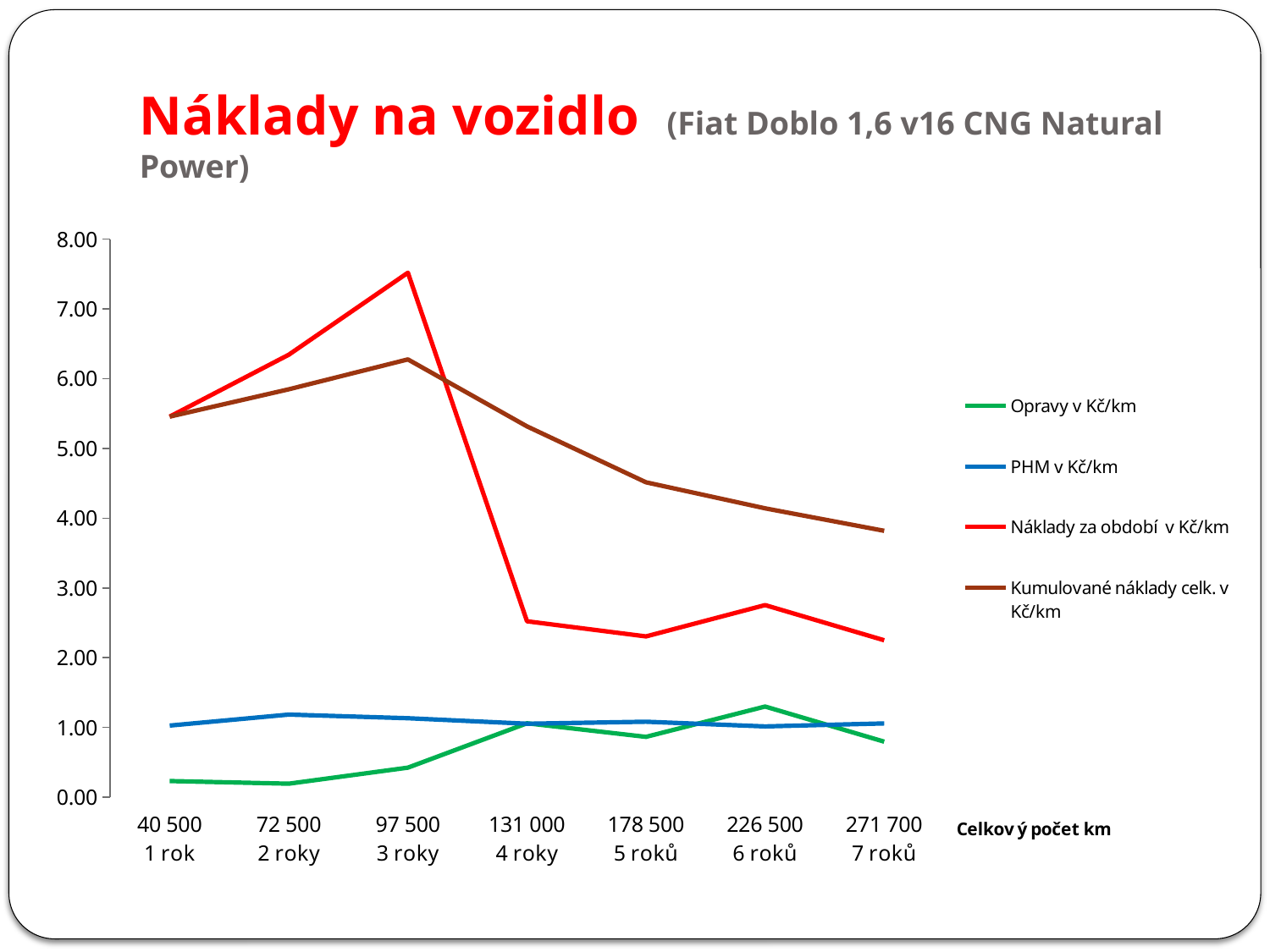
Is the value of 'Opravy v Kč/km' at 40 500 km (1 rok) greater or less than 1.00? less At 131 000 km (4 roky), which is higher: 'Náklady za období v Kč/km' or 'Kumulované náklady celk. v Kč/km'? Kumulované náklady celk. v Kč/km Is the value of 'Kumulované náklady celk. v Kč/km' at 97 500 km (3 roky) greater or less than 6.00? greater Is the value of 'Kumulované náklady celk. v Kč/km' at 271 700 km (7 roků) greater or less than 4.00? less What colour is the 'Opravy v Kč/km' line? green How many points along the x axis does each line have? 7 How many series does the legend list? 4 At 226 500 km (6 roků), which is higher: 'Opravy v Kč/km' or 'PHM v Kč/km'? Opravy v Kč/km Does the 'Kumulované náklady celk. v Kč/km' line rise or fall from 97 500 km to 271 700 km? fall At which x-axis category does the 'Náklady za období v Kč/km' line reach its highest value? 97 500 / 3 roky What kind of chart is shown on the slide? line chart